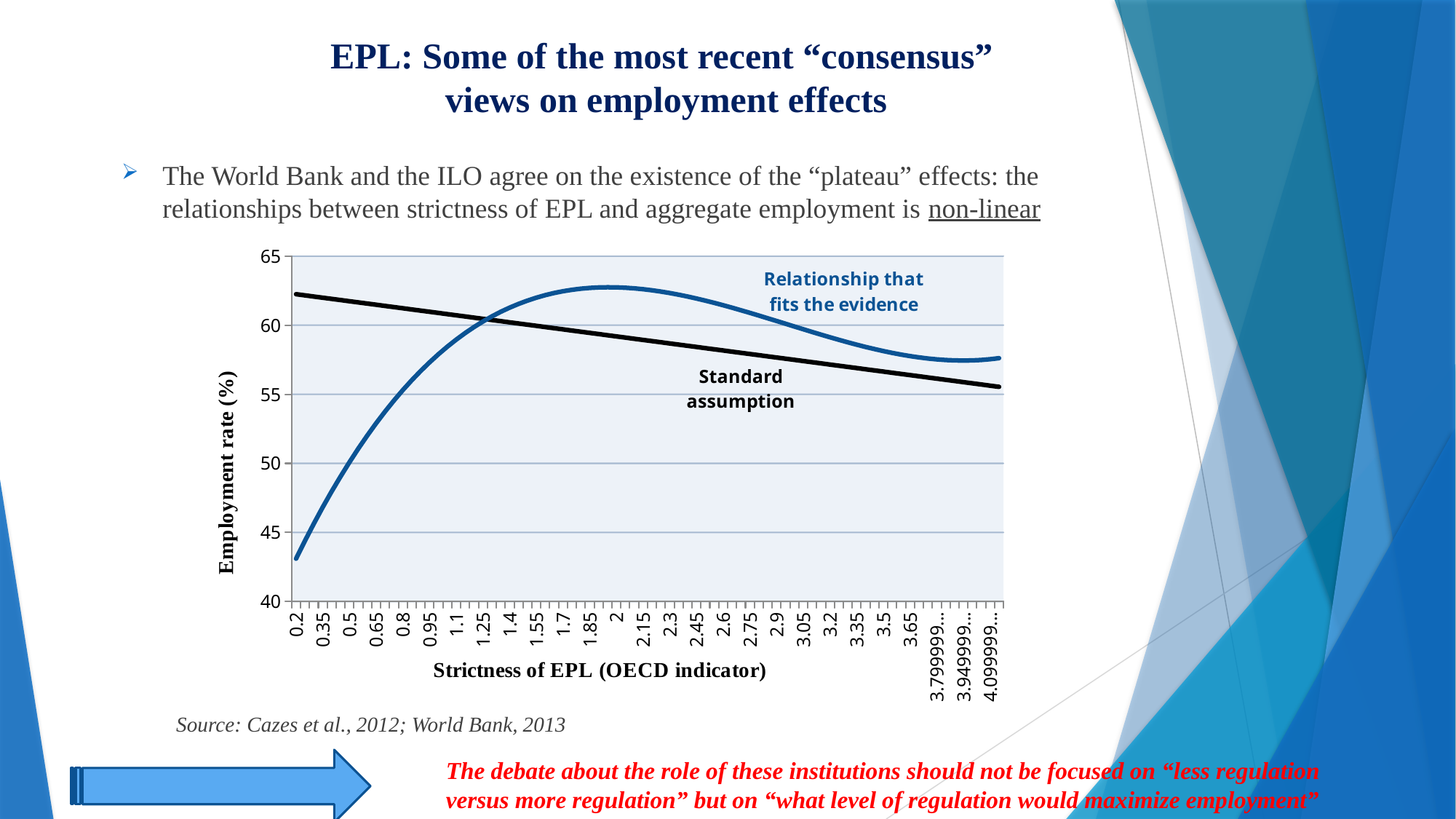
What is the title of the x axis of the chart? Strictness of EPL (OECD indicator) Does the 'Relationship that fits the evidence' curve rise or fall between 0.2 and 2 on the x axis? rise Is the value of 'Relationship that fits the evidence' at 2 greater or less than 60? greater At 0.2 on the x axis, which series has the higher employment rate, 'Standard assumption' or 'Relationship that fits the evidence'? Standard assumption What kind of chart is shown on the slide? line chart Is the value of 'Relationship that fits the evidence' at 3.5 greater or less than 55? greater Is the value of 'Standard assumption' at 0.2 greater or less than 60? greater How many series are plotted on the chart? 2 At 2 on the x axis, which series has the higher employment rate, 'Standard assumption' or 'Relationship that fits the evidence'? Relationship that fits the evidence Does the 'Standard assumption' line rise or fall as strictness of EPL increases along the x axis? fall What is the title of the y axis of the chart? Employment rate (%)